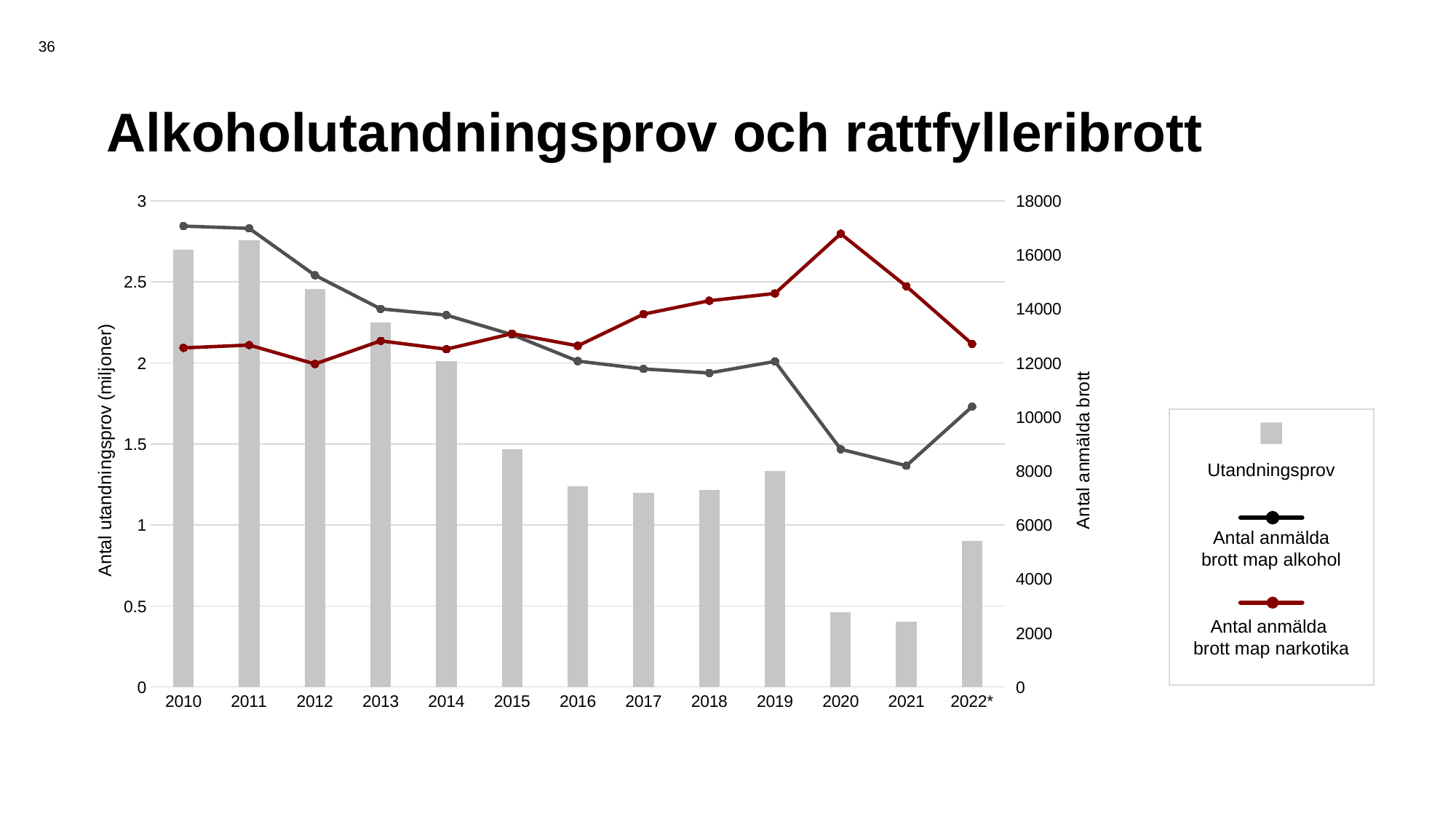
Is the Antal anmälda brott map narkotika value for 2020 greater or less than 16000? greater What is the title of the left vertical axis? Antal utandningsprov (miljoner) How many years are shown on the x axis? 13 In which year is the Utandningsprov bar the lowest? 2021 How many series does the legend list? 3 Is the Utandningsprov value for 2010 greater or less than 2.5? greater In 2010, which line is higher: Antal anmälda brott map alkohol or Antal anmälda brott map narkotika? Antal anmälda brott map alkohol In which year is the Antal anmälda brott map alkohol line at its lowest? 2021 Is the Utandningsprov value for 2022* greater or less than 1? less In which year is the Antal anmälda brott map narkotika line at its highest? 2020 What kind of chart is shown on the slide? A combined bar and line chart